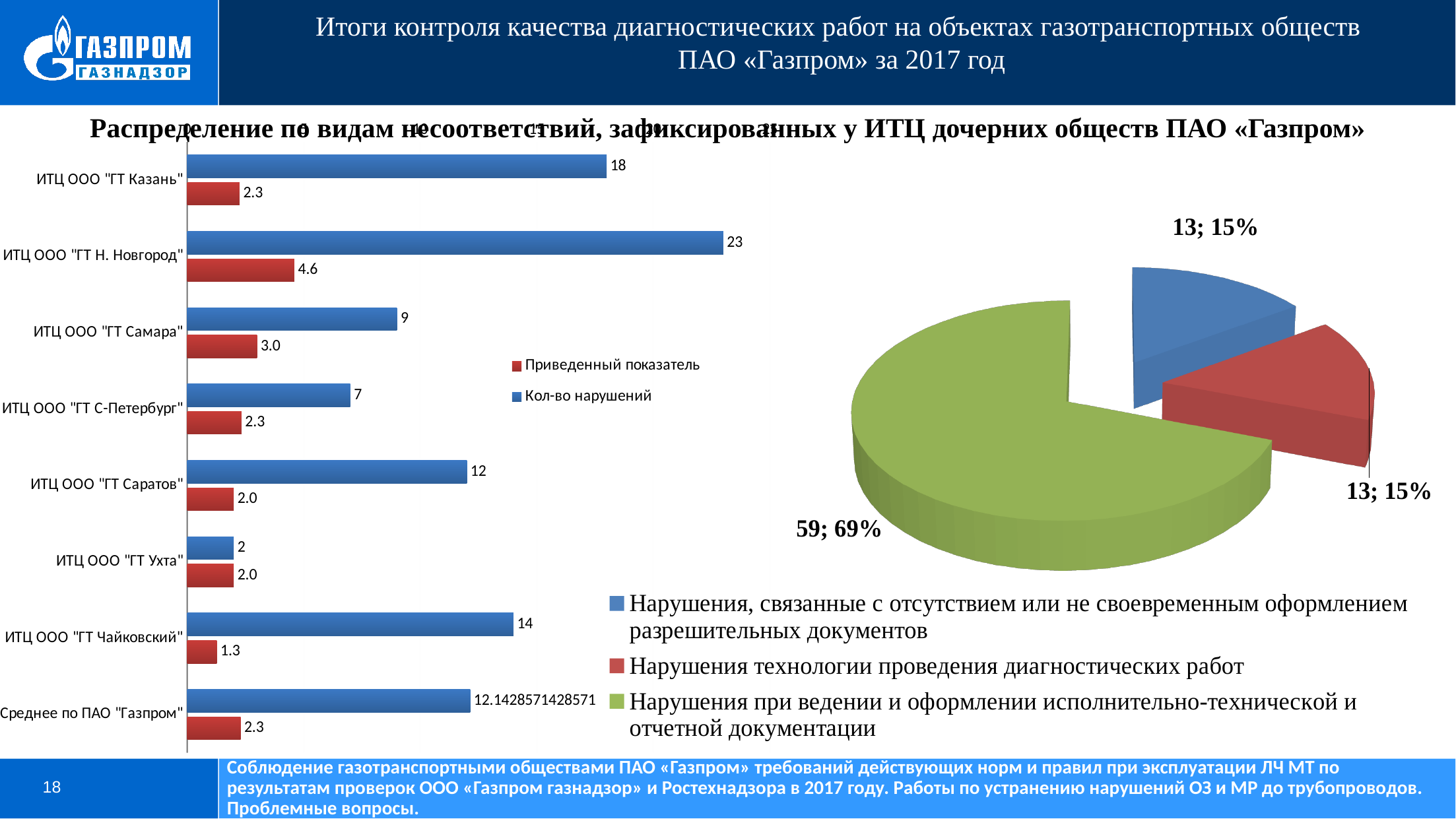
How many slices does the pie chart on the right have? 3 In the bar chart on the left, which category has the highest value of "Кол-во нарушений"? ИТЦ ООО "ГТ Н. Новгород" In the bar chart on the left, which has a larger "Кол-во нарушений": ИТЦ ООО "ГТ Саратов" or ИТЦ ООО "ГТ Самара"? ИТЦ ООО "ГТ Саратов" In the pie chart on the right, what share does the green slice (Нарушения при ведении и оформлении исполнительно-технической и отчетной документации) have? 69% In the bar chart on the left, what is the value of "Приведенный показатель" for ИТЦ ООО "ГТ Самара"? 3.0 How many categories are shown in the bar chart on the left? 8 In the bar chart on the left, what is the difference in "Кол-во нарушений" between ИТЦ ООО "ГТ Казань" and ИТЦ ООО "ГТ Чайковский"? 4 What type of chart is the chart on the left of the slide? bar chart In the bar chart on the left, which category has the lowest value of "Приведенный показатель"? ИТЦ ООО "ГТ Чайковский" How many series does the legend of the bar chart on the left list? 2 In the bar chart on the left, what is the value of "Кол-во нарушений" for ИТЦ ООО "ГТ Н. Новгород"? 23 In the pie chart on the right, what is the value of the slice for "Нарушения технологии проведения диагностических работ"? 13